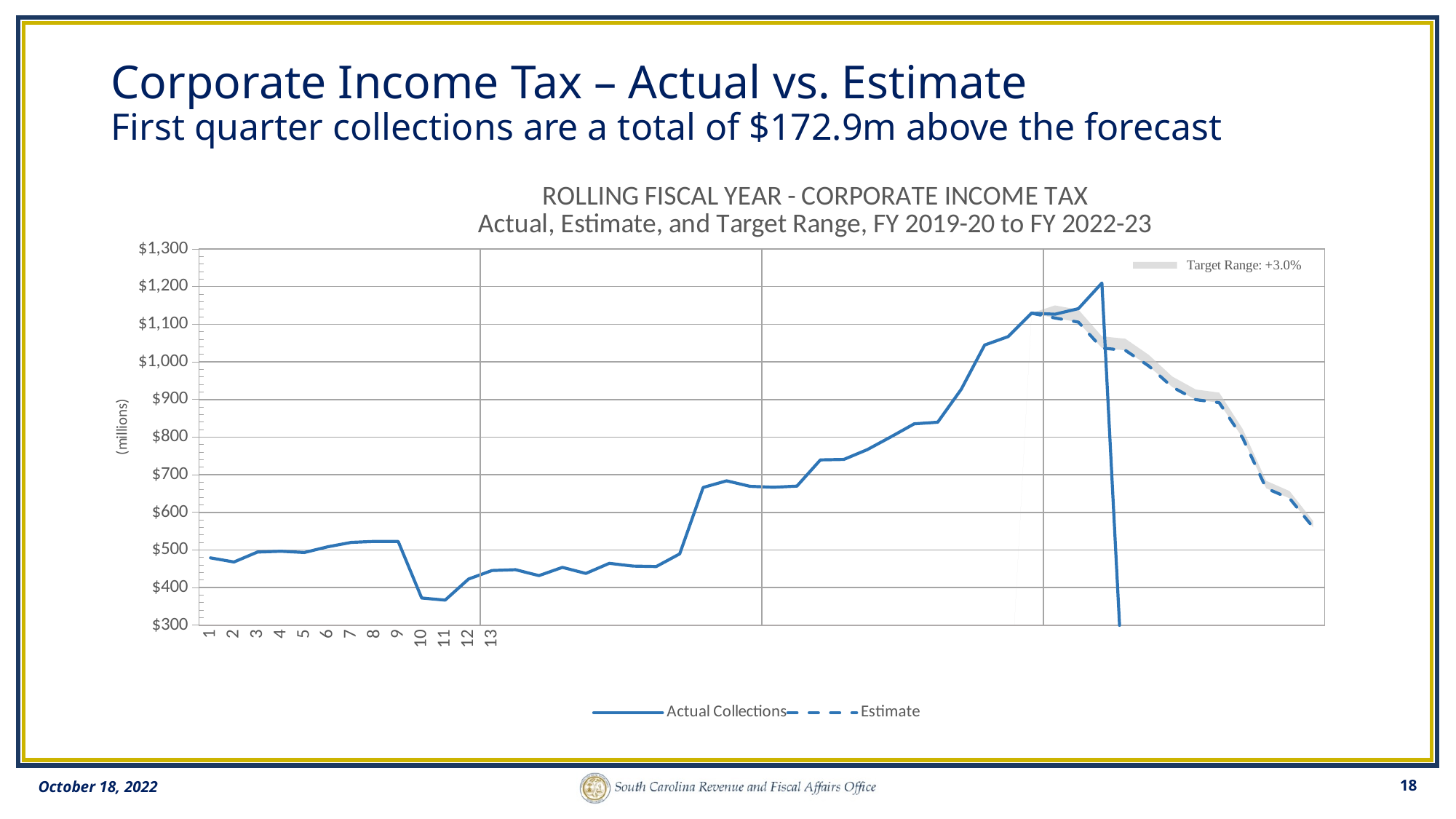
Is the Actual Collections value at point 9 greater or less than $500? greater Is the Actual Collections value at point 10 greater or less than $400? less Does the Actual Collections line rise or fall between point 9 and point 10? fall Is the Actual Collections value at point 1 greater or less than $500? less What kind of chart is shown on the slide? line chart What is the first line of the chart's title? ROLLING FISCAL YEAR - CORPORATE INCOME TAX How many series does the chart legend list? 2 Which is larger for Actual Collections: the value at point 9 or the value at point 10? point 9 Which is larger for Actual Collections: the value at point 1 or the value at point 11? point 1 What percentage is given for the Target Range in the chart? +3.0% What is the highest value shown on the chart's vertical axis? $1,300